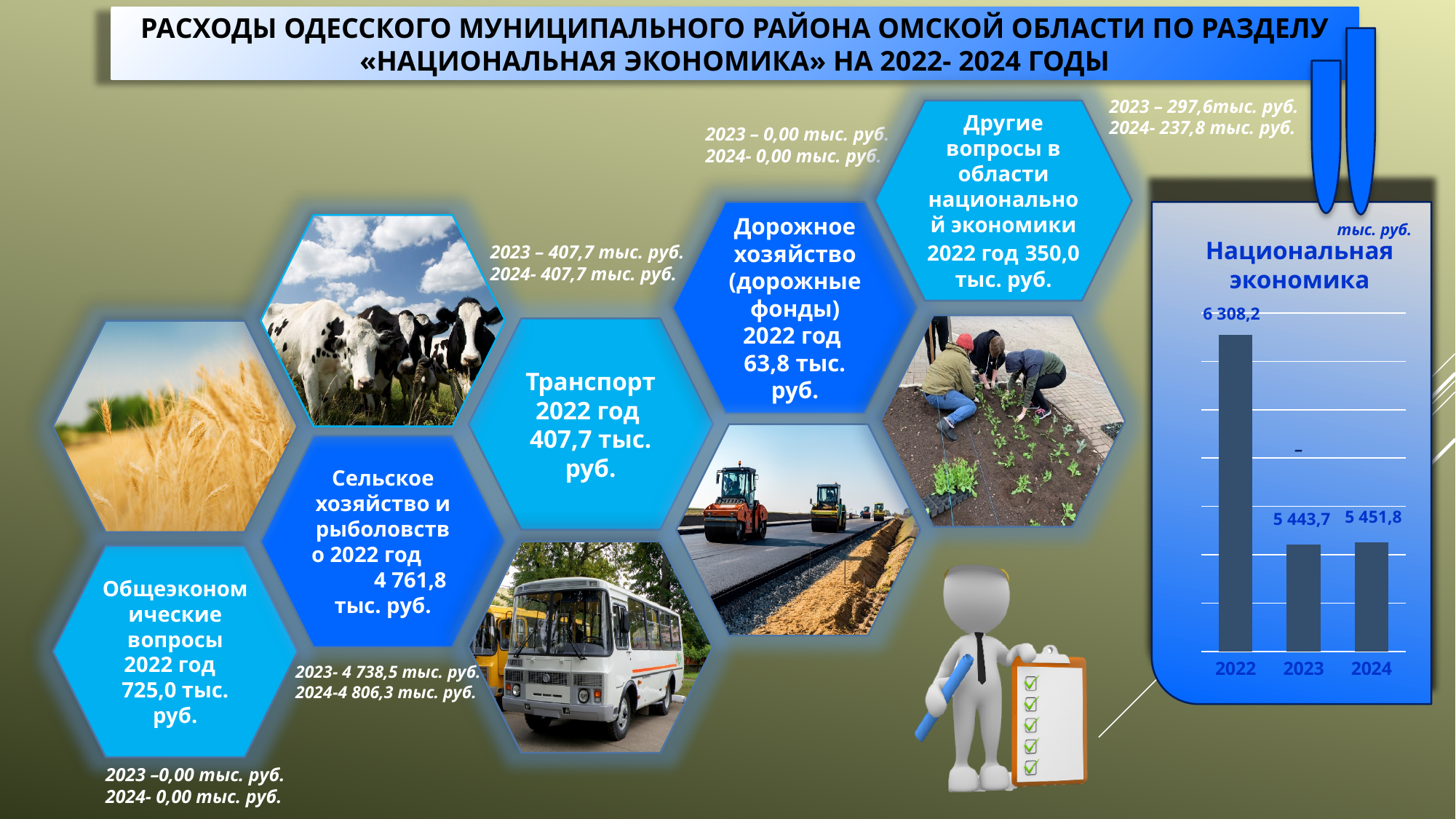
What is the value for 2023 in the 'Национальная экономика' chart? 5 443,7 What kind of chart is the 'Национальная экономика' chart? bar chart In the 'Национальная экономика' chart, what is the difference between the values for 2022 and 2023? 864,5 In the 'Национальная экономика' chart, what is the difference between the values for 2022 and 2024? 856,4 Which year has the highest value in the 'Национальная экономика' chart? 2022 In the 'Национальная экономика' chart, which is larger: the value for 2023 or the value for 2024? 2024 In the 'Национальная экономика' chart, does the value rise or fall from 2022 to 2023? fall How many years are shown in the 'Национальная экономика' chart? 3 What is the value for 2022 in the 'Национальная экономика' chart? 6 308,2 What unit is indicated for the values in the 'Национальная экономика' chart? тыс. руб. What is the value for 2024 in the 'Национальная экономика' chart? 5 451,8 Which year has the lowest value in the 'Национальная экономика' chart? 2023